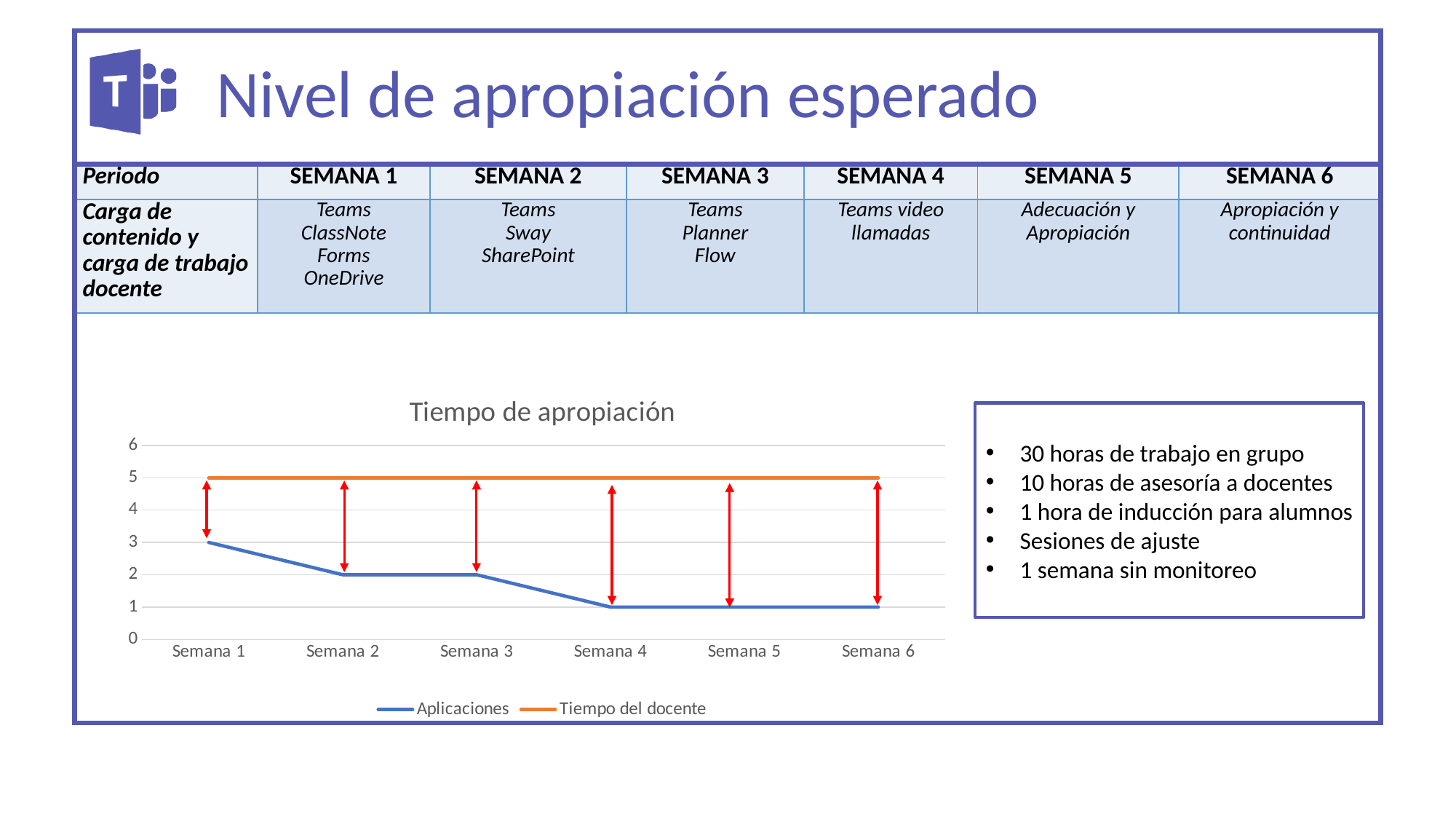
Does the Aplicaciones series rise or fall from Semana 1 to Semana 6? fall What is the difference between Tiempo del docente and Aplicaciones in Semana 1? 2 In which week is the Aplicaciones value highest? Semana 1 What is the difference between Tiempo del docente and Aplicaciones in Semana 6? 4 What is the value of Tiempo del docente for Semana 3? 5 What is the title of the chart? Tiempo de apropiación How many series does the chart legend list? 2 What is the value of Aplicaciones for Semana 4? 1 What is the value of Aplicaciones for Semana 1? 3 How many categories are shown on the x axis of the chart? 6 Which series has the larger value in Semana 2, Aplicaciones or Tiempo del docente? Tiempo del docente What type of chart is shown under the title "Tiempo de apropiación"? line chart